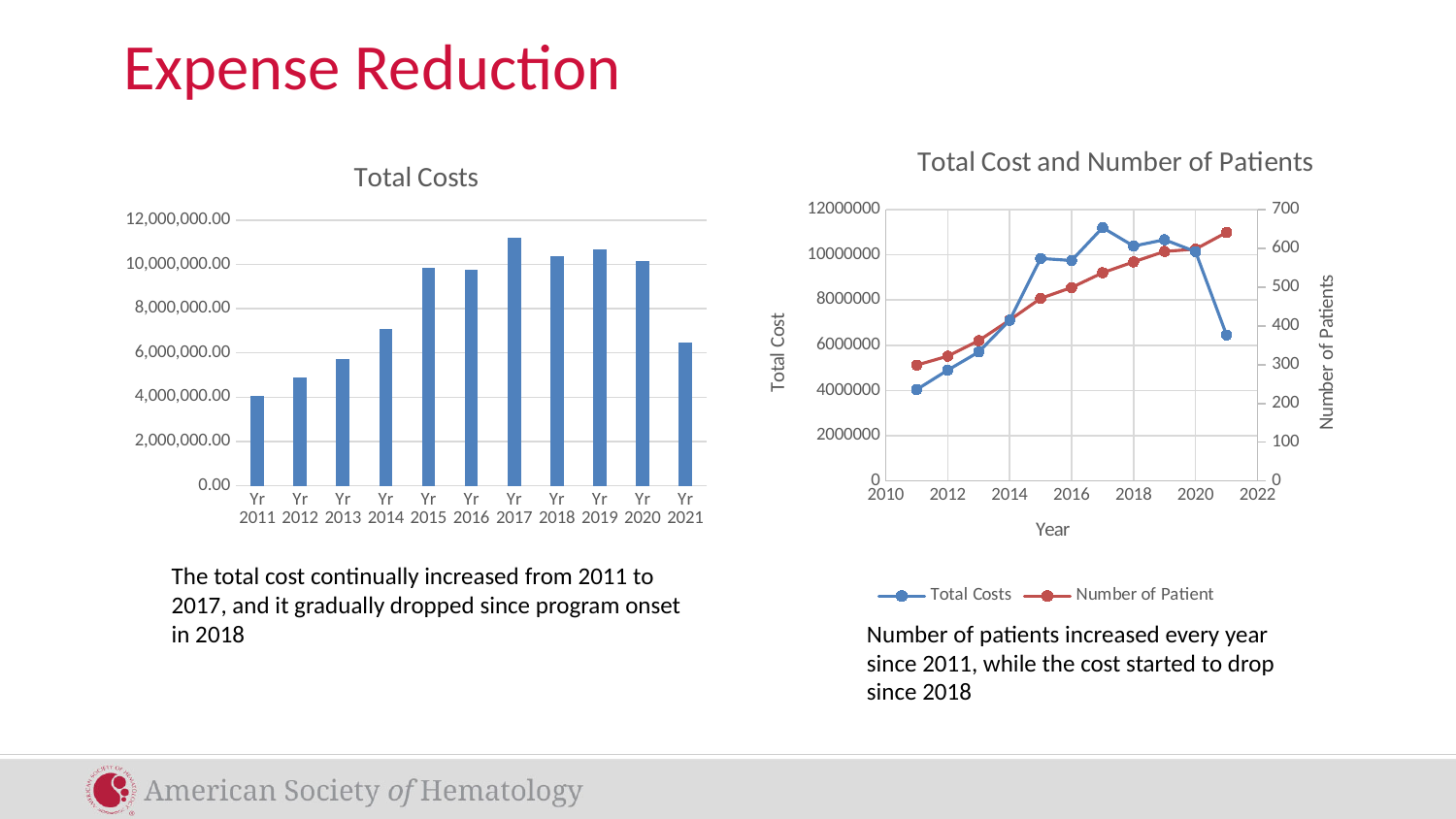
In the "Total Cost and Number of Patients" chart, is the Number of Patient value for 2021 greater or less than 600? greater In the "Total Costs" chart, which year has the highest total cost? Yr 2017 What kind of chart is the "Total Cost and Number of Patients" chart on the right? line chart In the "Total Costs" chart, which is larger, the total cost for Yr 2013 or for Yr 2018? Yr 2018 In the "Total Costs" chart, how many years are shown on the x axis? 11 In the "Total Costs" chart, which year has the lowest total cost? Yr 2011 In the "Total Cost and Number of Patients" chart, does the Number of Patient series rise or fall from 2011 to 2021? rise How many series does the legend of the "Total Cost and Number of Patients" chart list? 2 In the "Total Costs" chart, is the value for Yr 2021 greater or less than 8,000,000.00? less What kind of chart is the "Total Costs" chart on the left? bar chart In the "Total Costs" chart, is the value for Yr 2017 greater or less than 10,000,000.00? greater